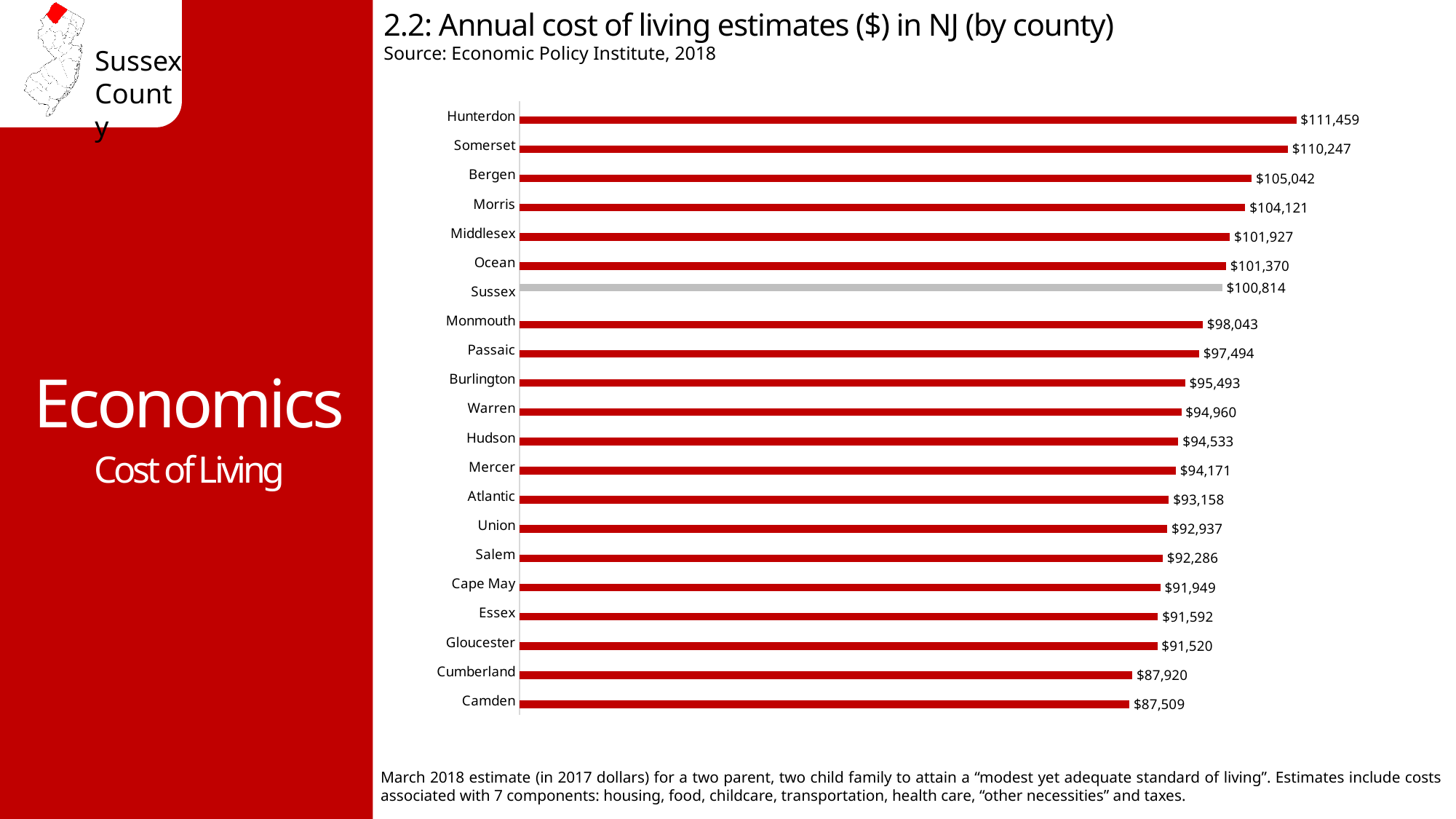
Which county has a higher cost of living estimate, Ocean or Passaic? Ocean Which county has the highest annual cost of living estimate? Hunterdon What is the difference between the cost of living estimates for Hunterdon and Camden? $23,950 How many counties are shown in the chart? 21 What is the annual cost of living estimate for Bergen County? $105,042 Which county has a higher cost of living estimate, Morris or Monmouth? Morris What type of chart is used to show the cost of living estimates? Bar chart What is the annual cost of living estimate for Cape May County? $91,949 What is the annual cost of living estimate for Sussex County? $100,814 Which county's bar is shown in a different colour (grey) from the others? Sussex Which county has the lowest annual cost of living estimate? Camden What is the difference between the cost of living estimates for Sussex and Camden? $13,305